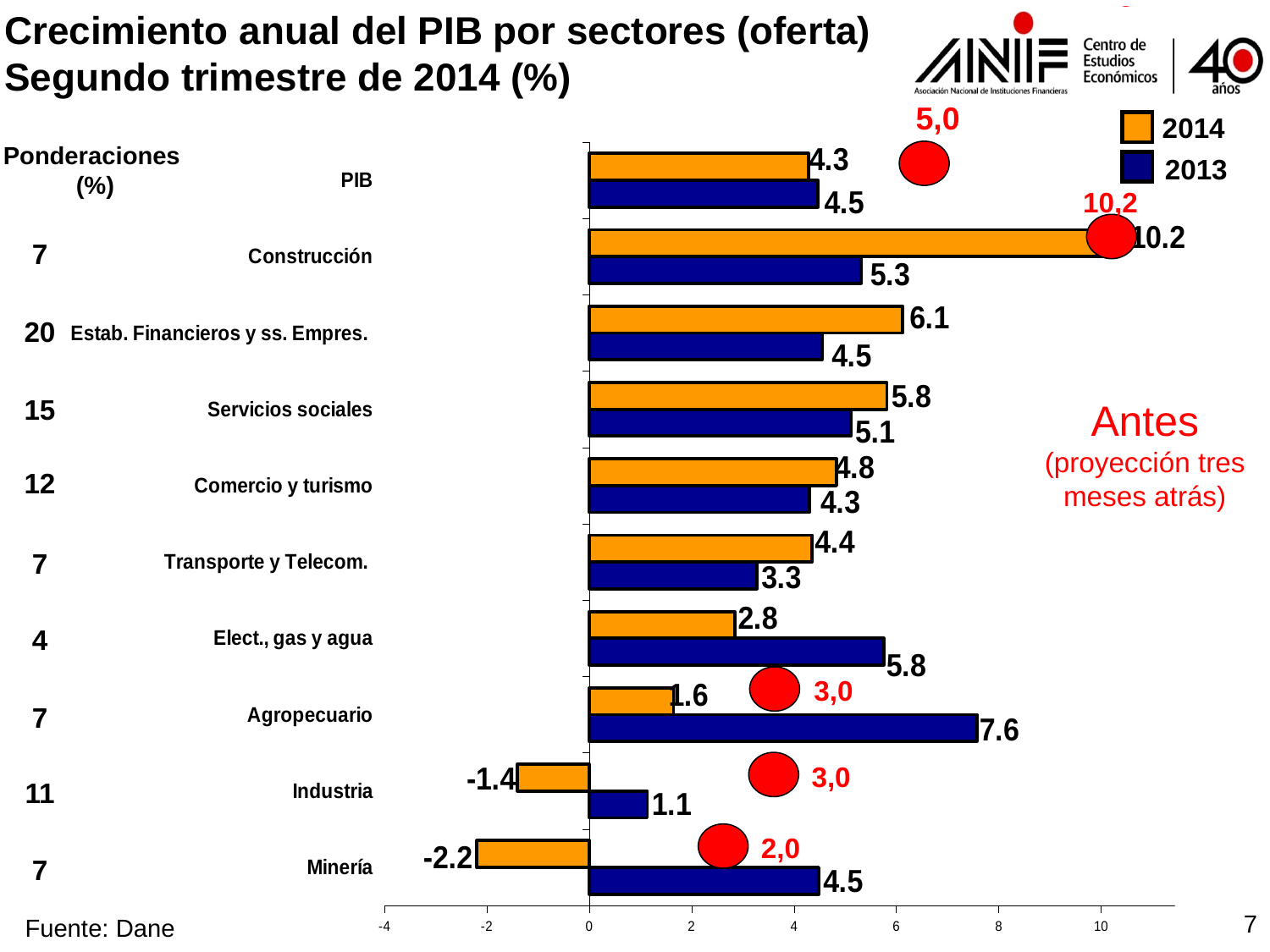
How many categories are plotted on the chart? 10 What kind of chart is shown on the slide? bar chart What is the 2013 value for Agropecuario? 7.6 What is the difference between the 2014 and 2013 values for Construcción? 4.9 Which category has the highest 2014 value? Construcción What is the 2014 value for Construcción? 10.2 How many series does the legend list? 2 Which category has the lowest 2014 value? Minería Which is larger for Elect., gas y agua: the 2014 value or the 2013 value? 2013 Which colour represents the 2014 series in the legend? orange What is the 2014 value for Minería? -2.2 Which is larger for Estab. Financieros y ss. Empres.: the 2014 value or the 2013 value? 2014